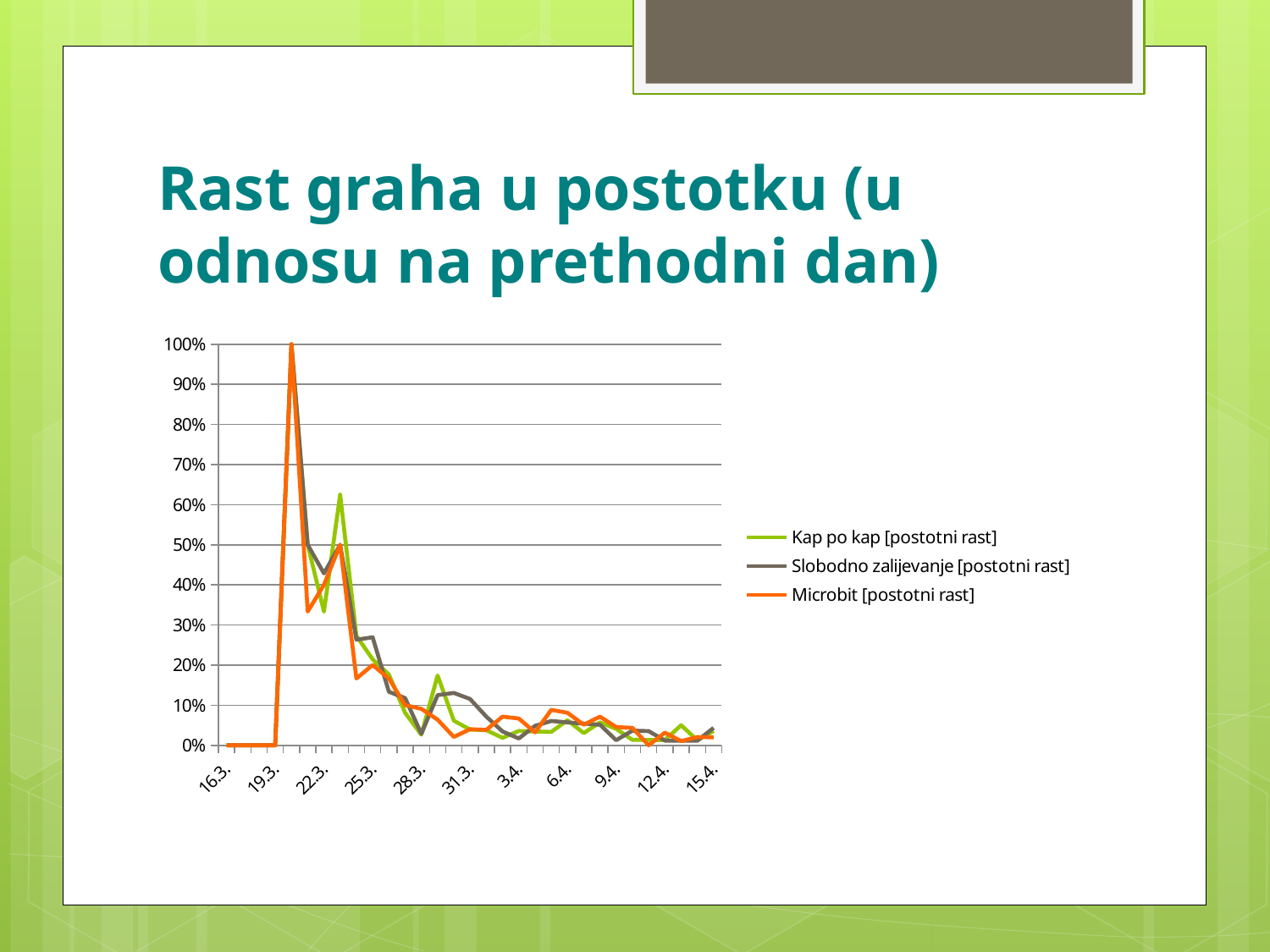
What kind of chart is shown on the slide? line chart Is the value for Microbit [postotni rast] on 25.3. greater or less than 30%? less Which series is drawn in orange according to the legend? Microbit [postotni rast] What is the highest value reached by the Microbit [postotni rast] series? 100% What is the value for Kap po kap [postotni rast] on 19.3.? 0% What is the value for Microbit [postotni rast] on 16.3.? 0% Is the value for Slobodno zalijevanje [postotni rast] on 15.4. greater or less than 20%? less How many series does the legend list? 3 How many date labels are shown on the x axis? 11 Do the values generally rise or fall along the x axis from 22.3. to 15.4.? fall Is the value for Kap po kap [postotni rast] on 22.3. greater or less than 50%? less What is the title of the slide containing the chart? Rast graha u postotku (u odnosu na prethodni dan)